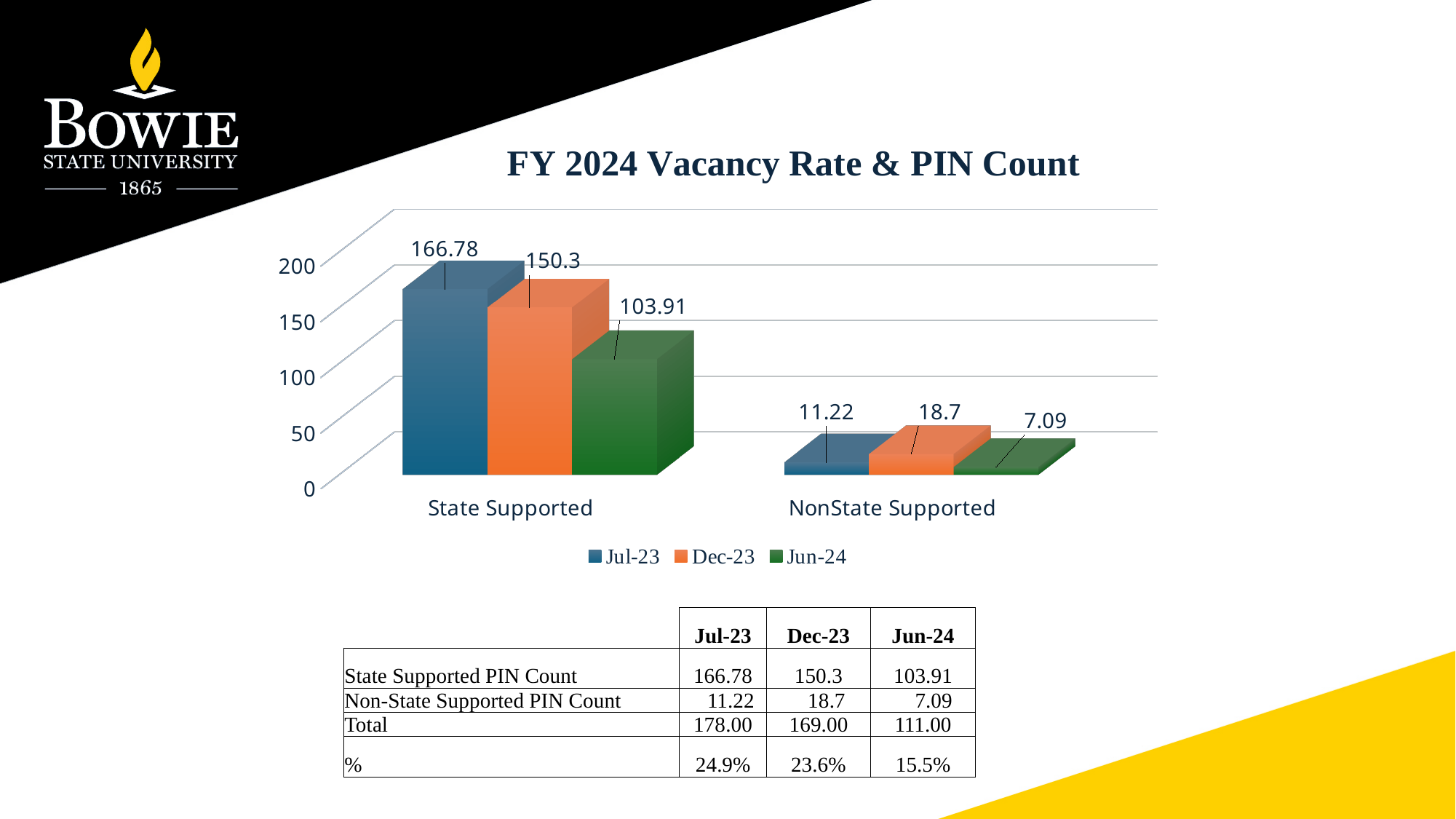
How many series does the legend list? 3 What is the value for State Supported in the Jul-23 series? 166.78 What is the title of the chart? FY 2024 Vacancy Rate & PIN Count Which series has the lowest value for NonState Supported? Jun-24 What is the value for NonState Supported in the Jun-24 series? 7.09 What is the value for State Supported in the Jun-24 series? 103.91 Which series has the highest value for State Supported? Jul-23 What is the difference between the Jul-23 and Jun-24 values for State Supported? 62.87 What is the value for NonState Supported in the Dec-23 series? 18.7 What kind of chart is shown on the slide? Bar chart Which is larger for NonState Supported: the Jul-23 value or the Dec-23 value? Dec-23 How many categories are shown on the x axis? 2